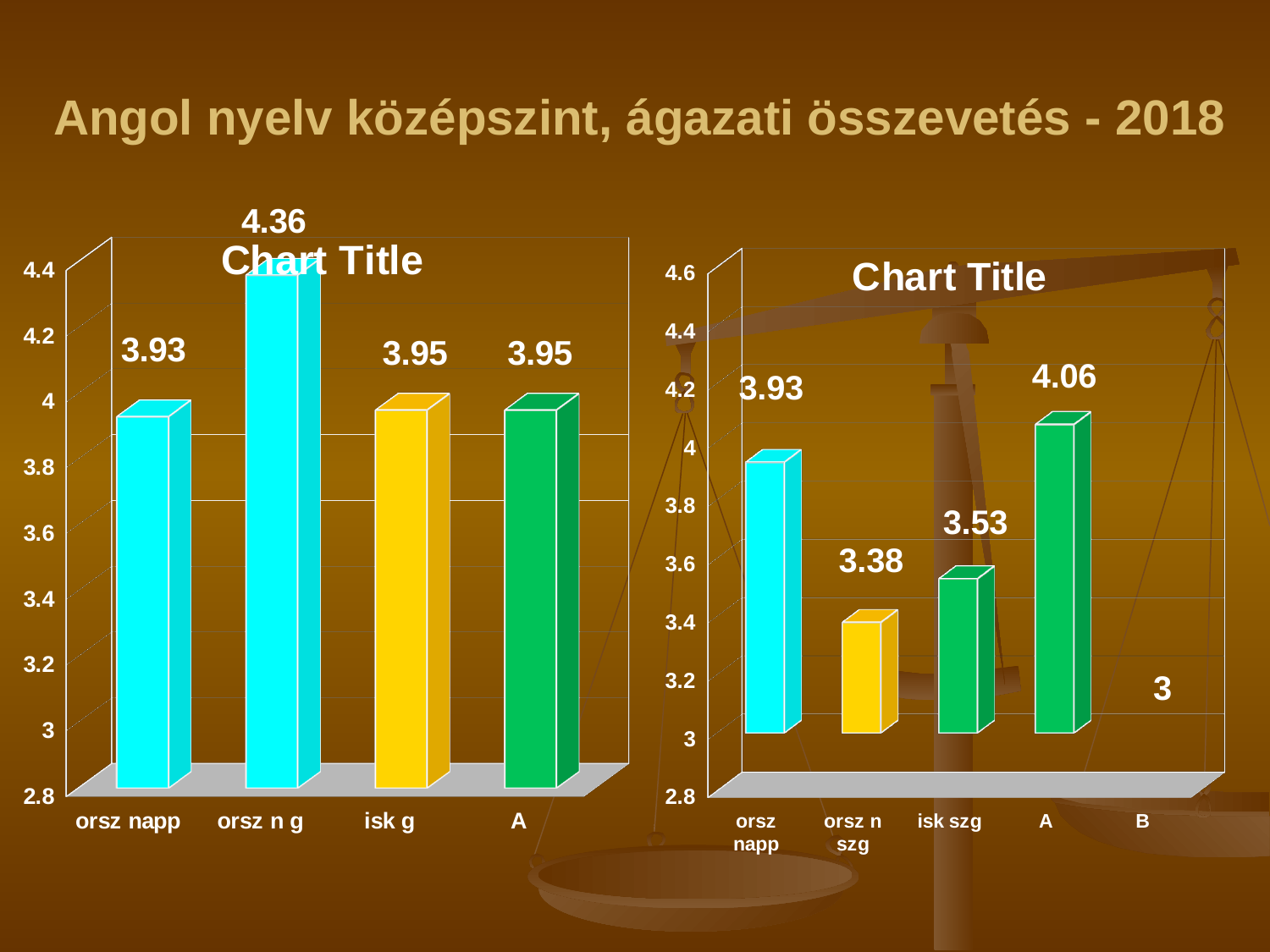
On the right chart, what is the difference between the values for A and orsz n szg? 0.68 On the left chart, how many categories are shown on the x axis? 4 On the left chart, which category has the highest value? orsz n g On the right chart, what is the value for isk szg? 3.53 On the left chart, what is the difference between the values for orsz n g and isk g? 0.41 What kind of chart is the right chart? bar chart On the right chart, which is larger, the value for orsz napp or the value for A? A On the left chart, what is the value for orsz n g? 4.36 On the left chart, what is the value for orsz napp? 3.93 On the left chart, which category has the lowest value? orsz napp On the right chart, what is the value for orsz n szg? 3.38 On the right chart, which category has the highest value? A